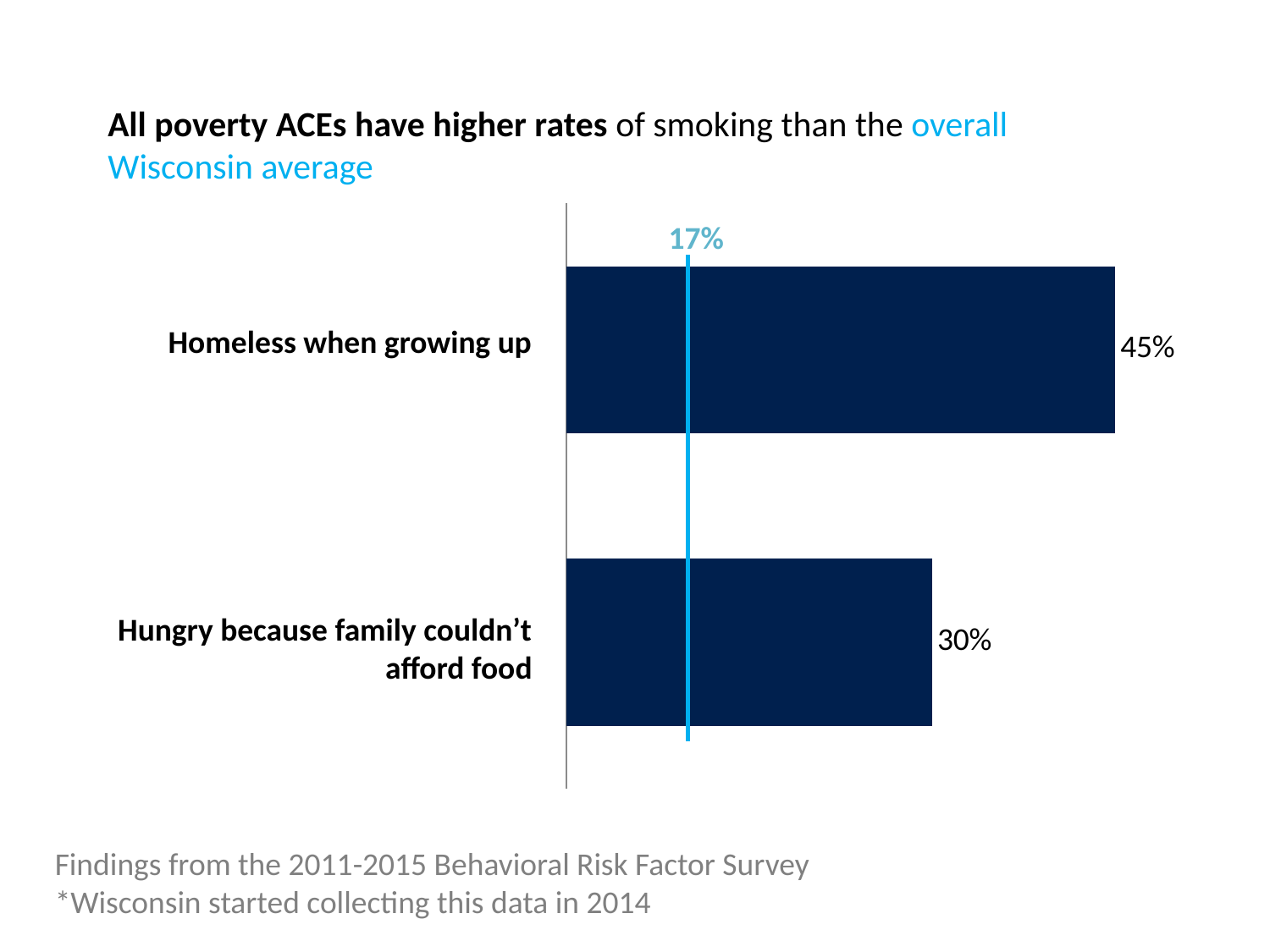
By how much does the 'Homeless when growing up' smoking rate exceed the 17% overall Wisconsin average? 28% How many categories are plotted in the chart? 2 What value does the vertical blue reference line mark? 17% What is the smoking rate for the 'Homeless when growing up' category? 45% What does the blue vertical line on the chart represent, according to the slide title? The overall Wisconsin average What kind of chart is shown on the slide? Bar chart Which category has the highest smoking rate? Homeless when growing up What is the smoking rate for the 'Hungry because family couldn't afford food' category? 30% Which category has the lowest smoking rate? Hungry because family couldn't afford food Which is larger: the smoking rate for 'Homeless when growing up' or for 'Hungry because family couldn't afford food'? Homeless when growing up What survey are the findings on the slide from? 2011-2015 Behavioral Risk Factor Survey What is the difference between the smoking rates for 'Homeless when growing up' and 'Hungry because family couldn't afford food'? 15%